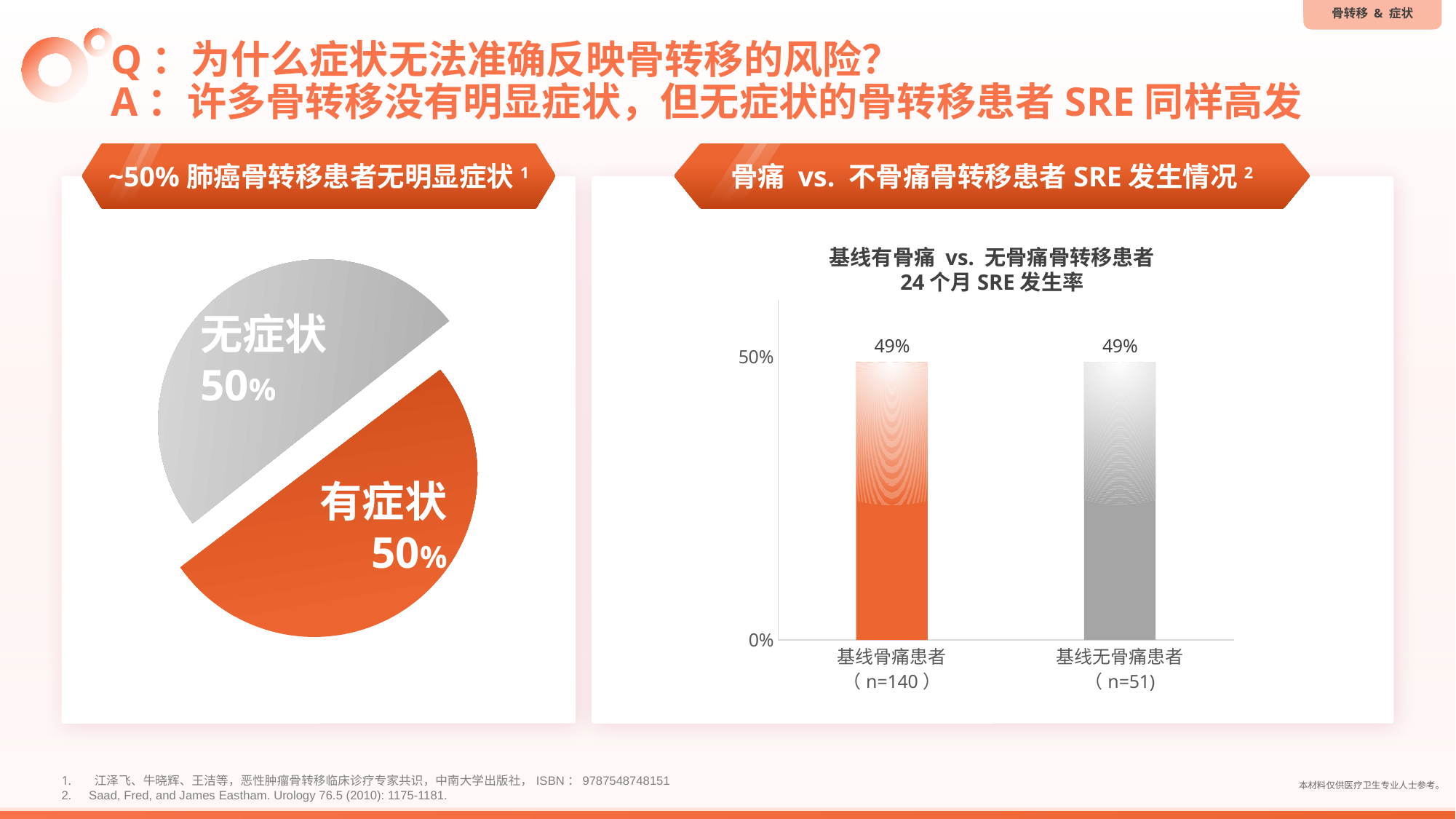
In the pie chart on the left, which slice is coloured orange? 有症状 How many bars are shown in the bar chart on the right? 2 What kind of chart is shown on the left side of the slide? pie chart What kind of chart is shown on the right side of the slide? bar chart In the pie chart on the left, what share of patients is labelled 无症状? 50% In the bar chart on the right, what is the 24-month SRE rate for 基线无骨痛患者 (n=51)? 49% In the bar chart on the right, what is the 24-month SRE rate for 基线骨痛患者 (n=140)? 49% In the pie chart on the left, what share of patients is labelled 有症状? 50% In the bar chart on the right, what is the difference between the SRE rates of 基线骨痛患者 and 基线无骨痛患者? 0% What is the title of the bar chart on the right? 基线有骨痛 vs. 无骨痛骨转移患者 24 个月 SRE 发生率 In the bar chart on the right, is the value for 基线骨痛患者 greater or less than 50%? less How many slices does the pie chart on the left have? 2